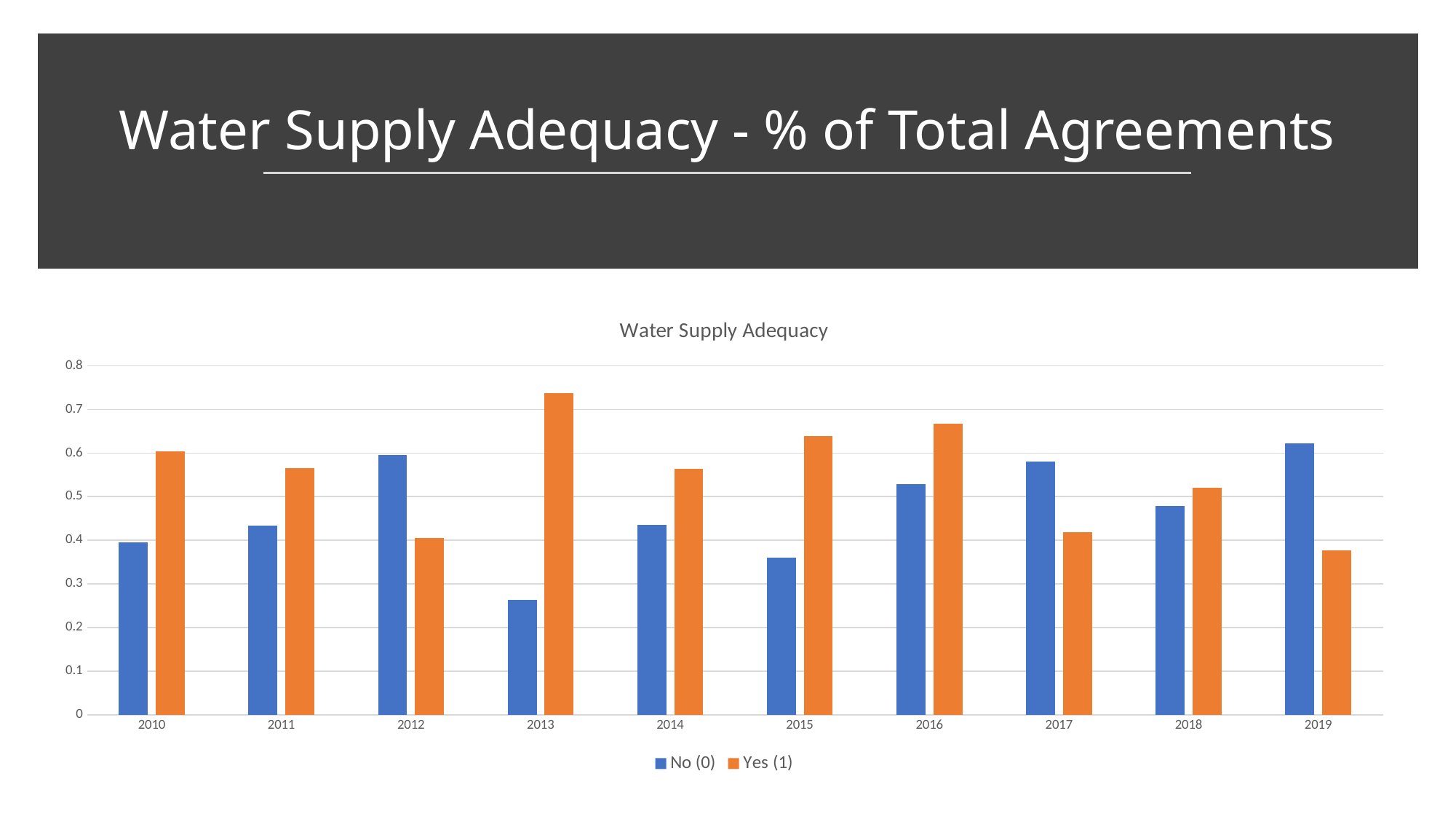
What kind of chart is shown on the slide? bar chart How many series does the legend list? 2 Is the Yes (1) value for 2019 greater or less than 0.4? less What is the title shown above the chart? Water Supply Adequacy Is the Yes (1) value for 2013 greater or less than 0.7? greater In 2017, which series has the larger value, No (0) or Yes (1)? No (0) In 2015, which series has the larger value, No (0) or Yes (1)? Yes (1) How many years are shown on the x axis? 10 Is the No (0) value for 2013 greater or less than 0.3? less In which year is the No (0) value lowest? 2013 In which year is the Yes (1) value highest? 2013